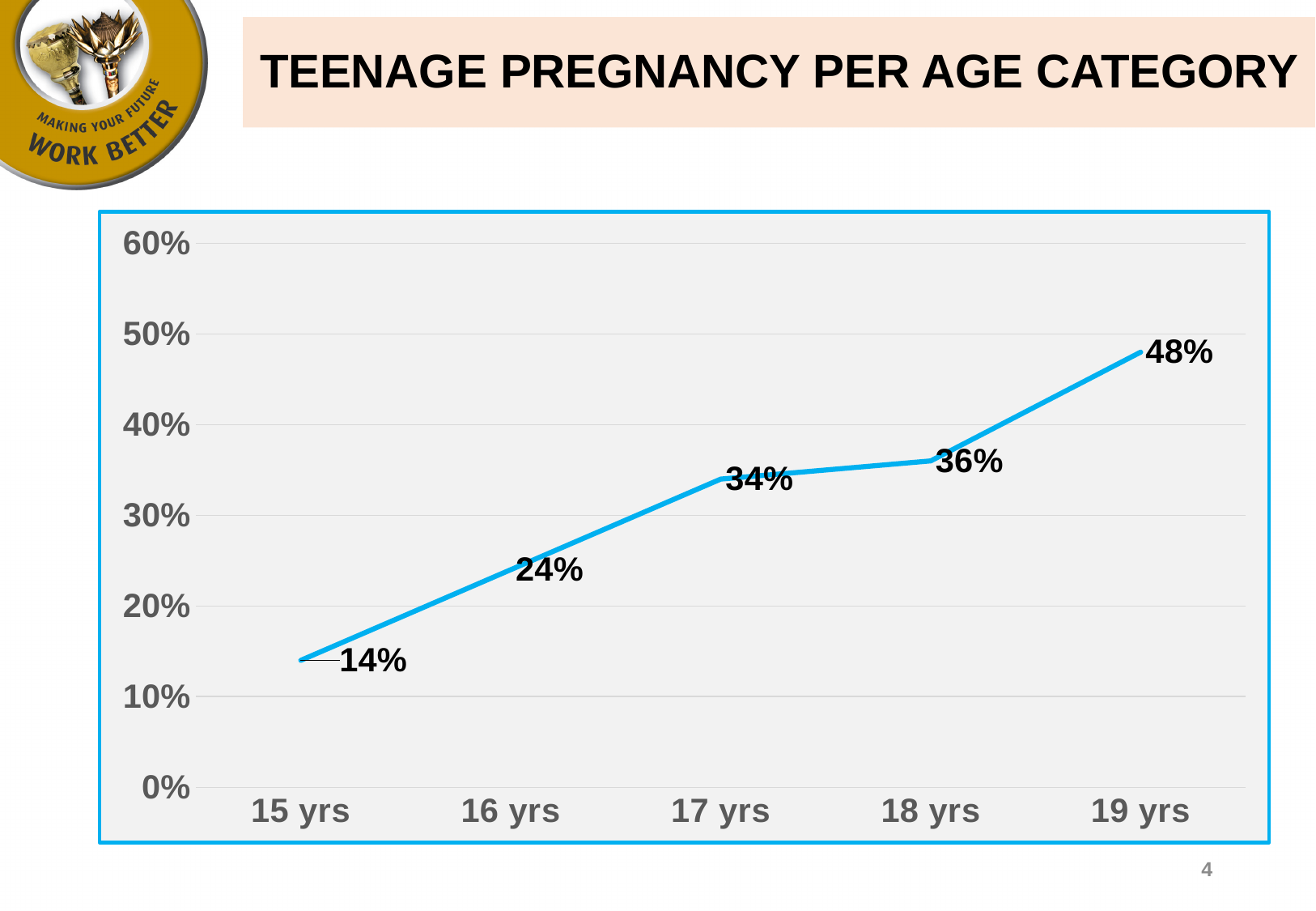
What is the difference between the values for 19 yrs and 18 yrs? 12% What is the difference between the values for 16 yrs and 15 yrs? 10% What kind of chart is shown on the slide? line chart What is the value for 19 yrs? 48% Which age category has the highest value? 19 yrs What is the value for 17 yrs? 34% What is the value for 15 yrs? 14% Is the value for 19 yrs greater or less than 50%? less How many age categories are plotted on the chart? 5 Do the values rise or fall from 15 yrs to 19 yrs? rise Which age category has the lowest value? 15 yrs Which is larger, the value for 17 yrs or the value for 18 yrs? 18 yrs